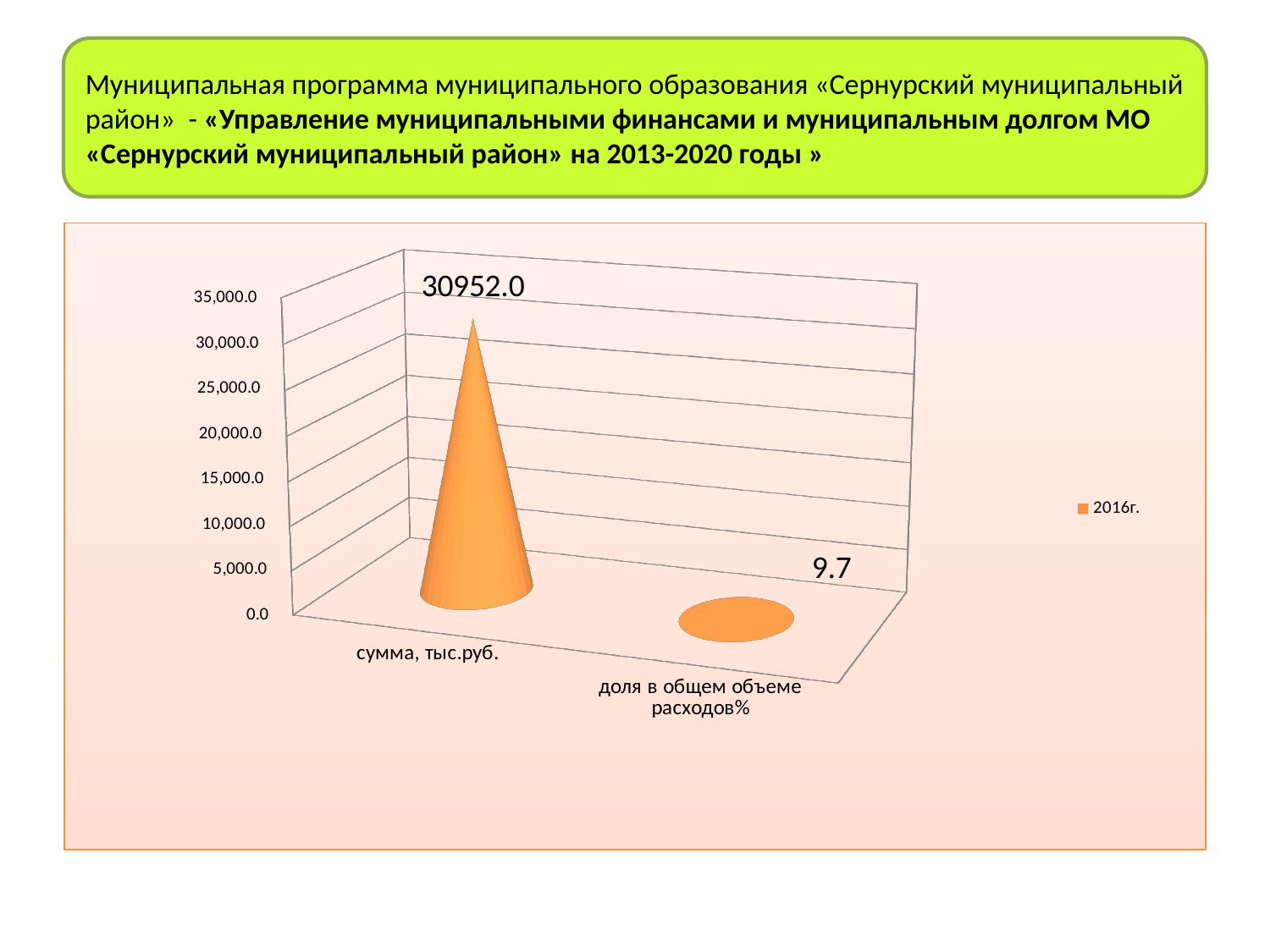
How many series does the legend list? 1 Which category has the highest value on the chart? сумма, тыс.руб. What is the legend entry shown on the chart? 2016г. Which is larger: the value for «сумма, тыс.руб.» or the value for «доля в общем объеме расходов%»? сумма, тыс.руб. Is the value for «сумма, тыс.руб.» greater or less than 25,000.0? greater How many categories are shown on the chart? 2 What is the value for «доля в общем объеме расходов%» on the chart? 9.7 Is the value for «доля в общем объеме расходов%» greater or less than 5,000.0? less What is the value for «сумма, тыс.руб.» on the chart? 30952.0 What kind of chart is shown on the slide? bar chart What is the difference between the value for «сумма, тыс.руб.» and the value for «доля в общем объеме расходов%»? 30942.3 Which category has the lowest value on the chart? доля в общем объеме расходов%